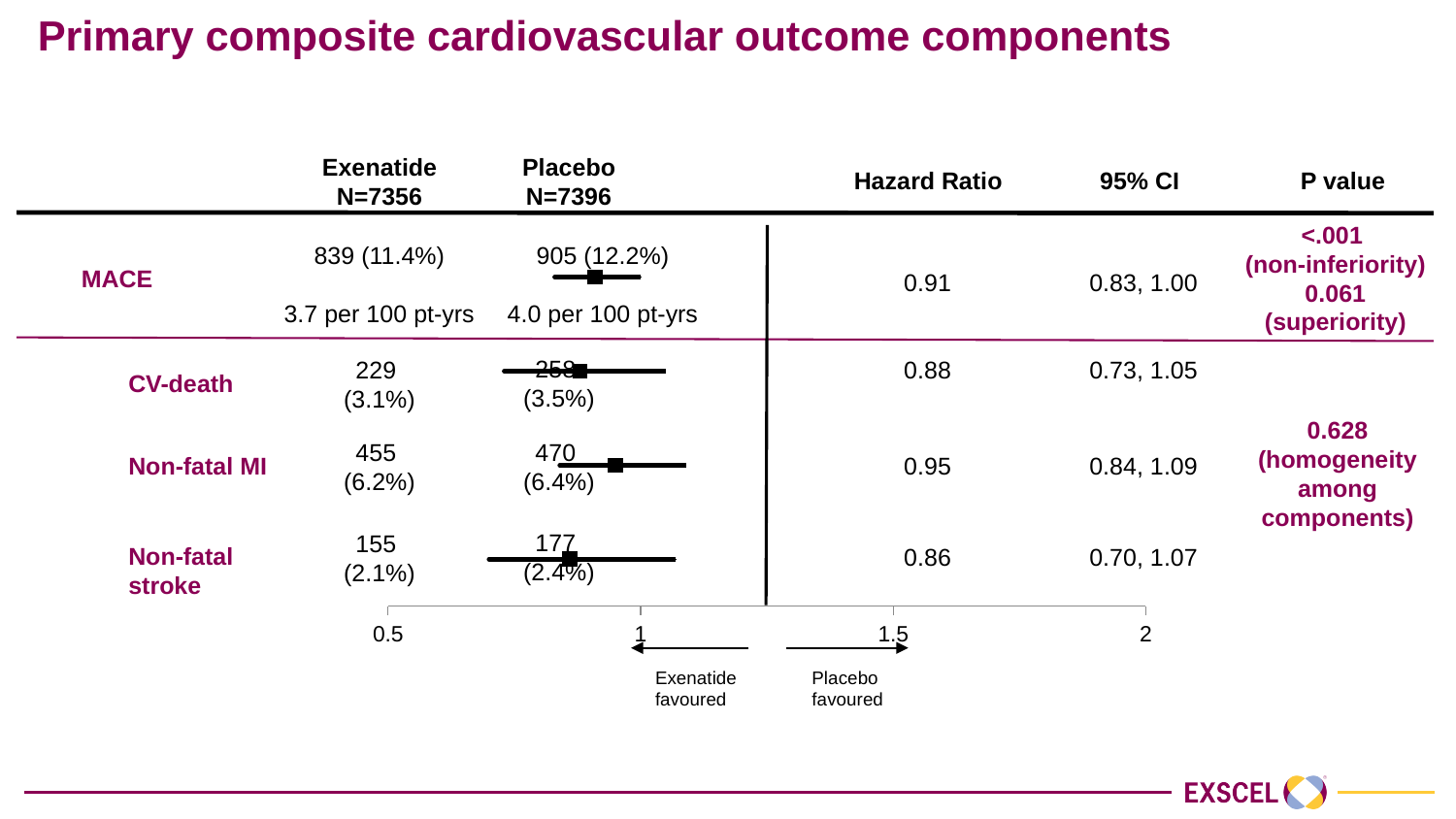
Which has the larger hazard ratio, CV-death or non-fatal MI? Non-fatal MI How many outcomes are plotted in the forest plot? 4 What is the MACE event rate per 100 patient-years in the exenatide group? 3.7 per 100 pt-yrs What is the hazard ratio for MACE? 0.91 How many more non-fatal MI events occurred in the placebo group than in the exenatide group? 15 Is the hazard ratio point estimate for MACE greater or less than 1? less What does the arrow pointing left below the x axis indicate? Exenatide favoured Which outcome has the lowest hazard ratio? Non-fatal stroke What kind of chart is shown on the slide? Forest plot How many more MACE events occurred in the placebo group than in the exenatide group? 66 What is the 95% CI for non-fatal stroke? 0.70, 1.07 Which of the three individual components (CV-death, non-fatal MI, non-fatal stroke) has the highest hazard ratio? Non-fatal MI